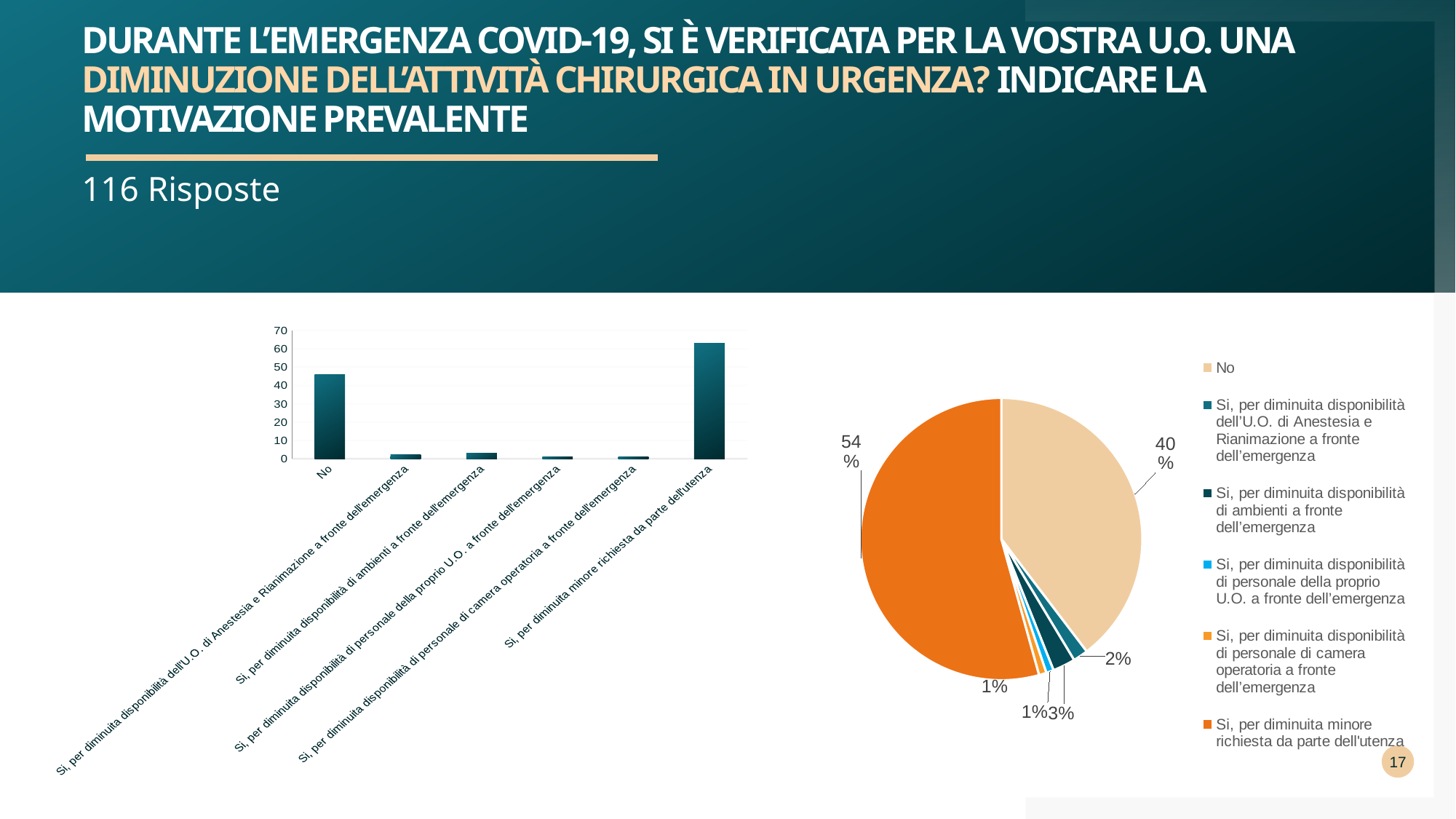
How many categories are shown on the x axis of the bar chart on the left? 6 In the pie chart on the right, what share of responses is "Si, per diminuita disponibilità dell'U.O. di Anestesia e Rianimazione a fronte dell'emergenza"? 2% In the pie chart on the right, what share of responses is "Si, per diminuita minore richiesta da parte dell'utenza"? 54% In the pie chart on the right, which category has the largest slice? Si, per diminuita minore richiesta da parte dell'utenza In the bar chart on the left, which category has the tallest bar? Si, per diminuita minore richiesta da parte dell'utenza In the pie chart on the right, how many percentage points larger is the "Si, per diminuita minore richiesta da parte dell'utenza" slice than the "No" slice? 14 percentage points In the pie chart on the right, what share of responses is "No"? 40% In the bar chart on the left, is the value for "Si, per diminuita minore richiesta da parte dell'utenza" greater or less than 50? greater What kind of chart is the chart on the left of the slide? Bar chart In the bar chart on the left, is the value for "No" greater or less than 40? greater How many entries does the legend of the pie chart on the right list? 6